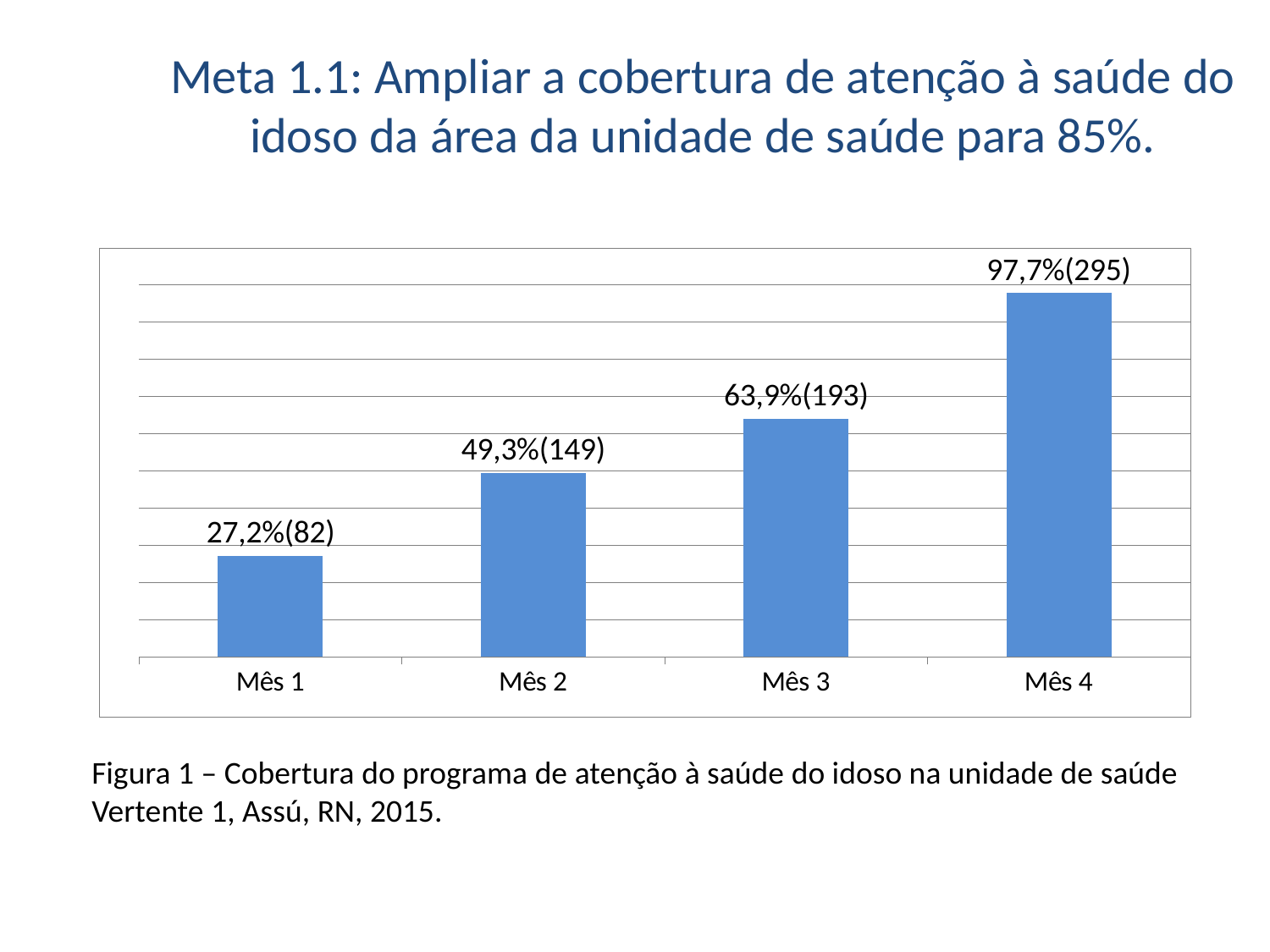
How many months (categories) are shown on the x axis? 4 What is the data label shown for Mês 4? 97,7%(295) Which month has the lowest bar? Mês 1 Do the values rise or fall from Mês 1 to Mês 4? Rise What kind of chart is shown on the slide? Bar chart What is the data label shown for Mês 2? 49,3%(149) What is the difference in the number of people (in parentheses) between Mês 4 and Mês 1? 213 What is the data label shown for Mês 1? 27,2%(82) Which is larger, the value for Mês 2 or the value for Mês 3? Mês 3 What is the difference in percentage points between Mês 3 and Mês 2? 14,6 Which month has the highest bar? Mês 4 What is the data label shown for Mês 3? 63,9%(193)